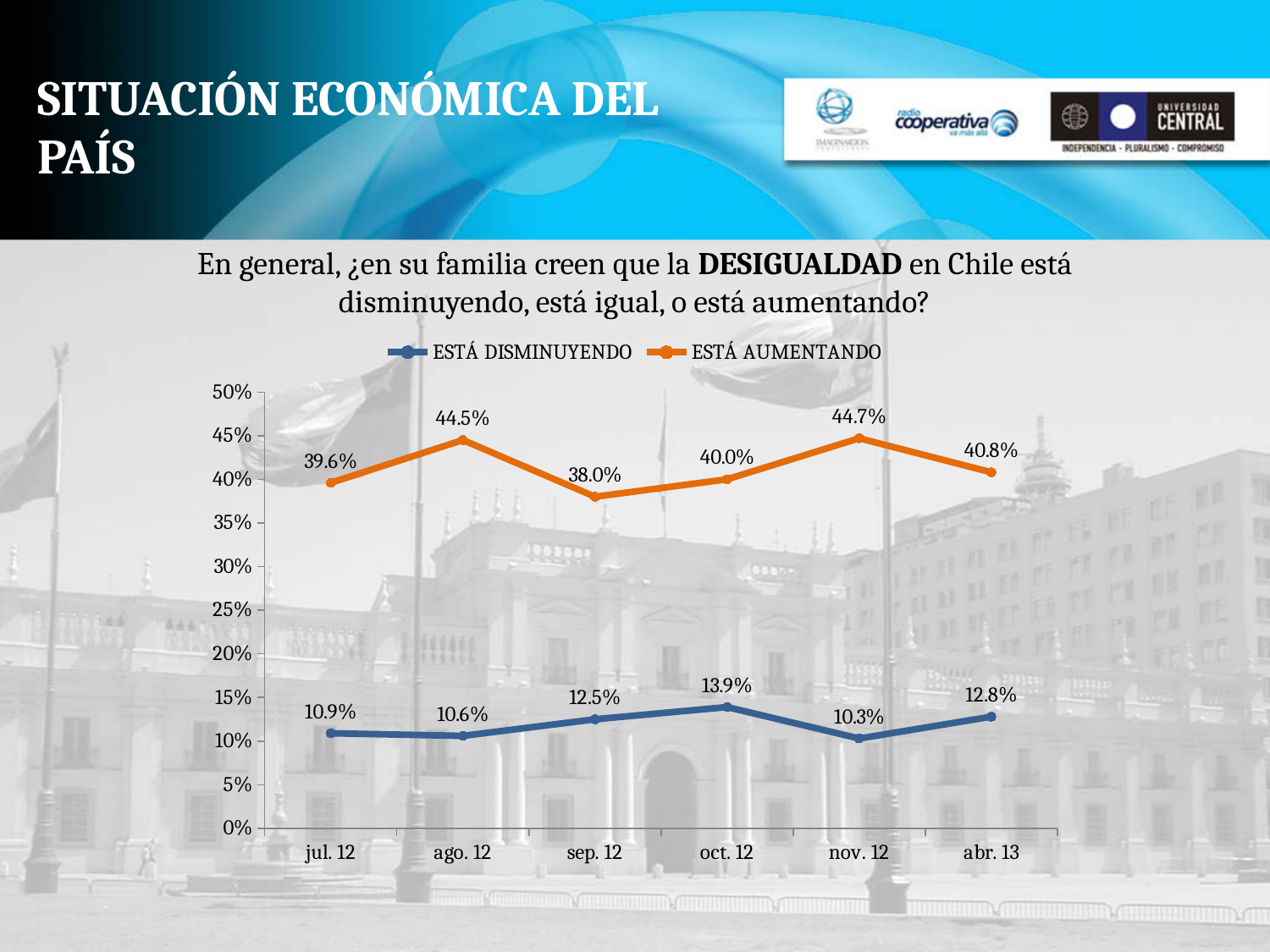
Is the value for ESTÁ AUMENTANDO in abr. 13 greater or less than 35%? greater What is the value for ESTÁ DISMINUYENDO in oct. 12? 13.9% Which is larger: ESTÁ AUMENTANDO in sep. 12 or ESTÁ AUMENTANDO in oct. 12? oct. 12 In which month does ESTÁ AUMENTANDO reach its highest value? nov. 12 What kind of chart is shown on the slide? Line chart What is the difference between ESTÁ AUMENTANDO and ESTÁ DISMINUYENDO in jul. 12? 28.7% What is the value for ESTÁ AUMENTANDO in ago. 12? 44.5% What is the value for ESTÁ DISMINUYENDO in abr. 13? 12.8% How many series does the legend list? 2 How many time points are shown on the x axis? 6 In which month does ESTÁ DISMINUYENDO have its lowest value? nov. 12 Which colour is used for the ESTÁ AUMENTANDO series? Orange